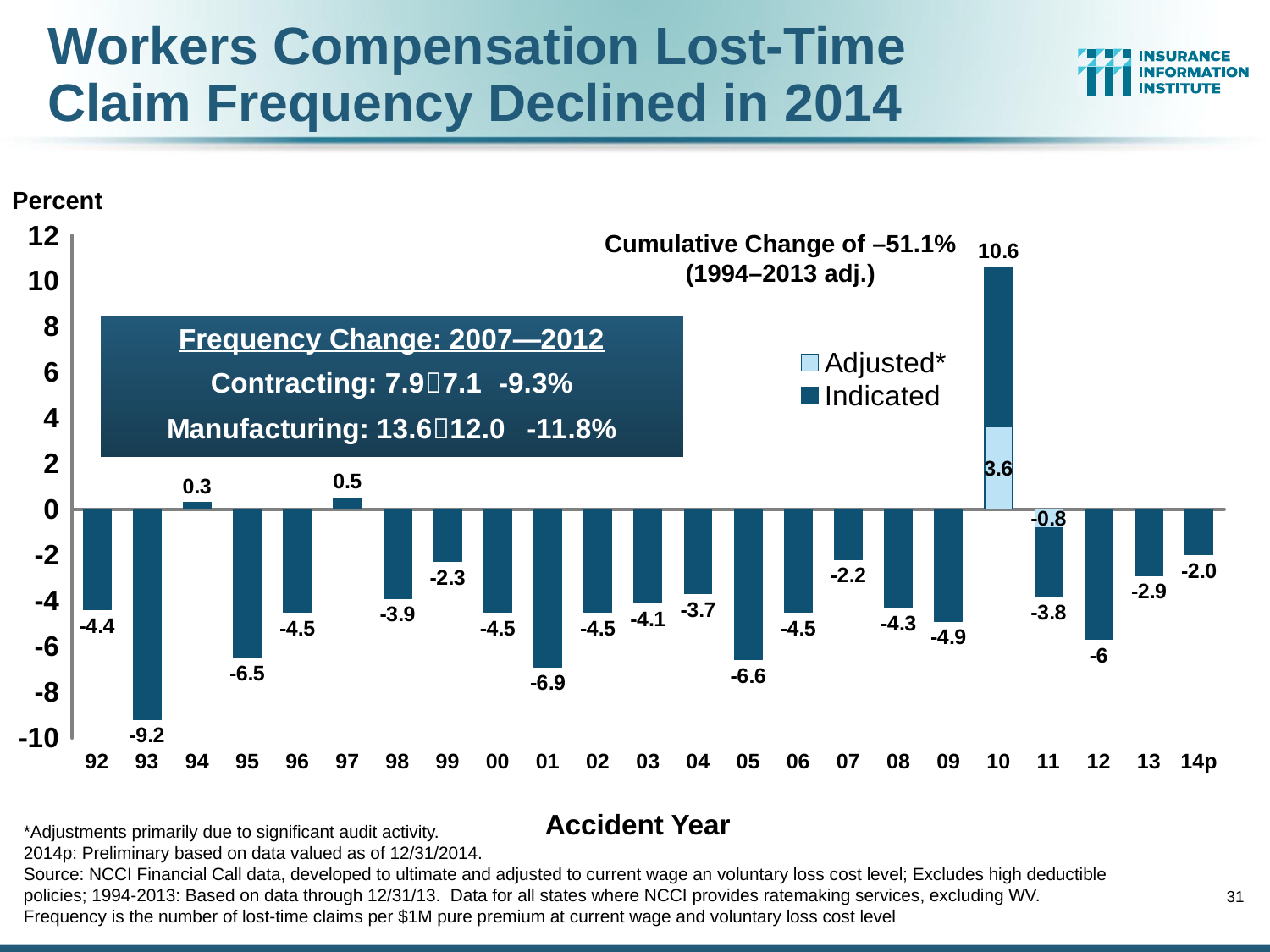
Which accident year has the larger value, 94 or 97? 97 What is the value for accident year 93? -9.2 Which accident year has the lowest value on the chart? 93 What is the value for accident year 14p? -2.0 How many series does the legend list? 2 What are the two entries in the chart legend? Adjusted* and Indicated How many accident years are shown on the x axis? 23 What is the Adjusted value shown for accident year 10? 3.6 What is the value for accident year 12? -6 Which accident year has the highest value on the chart? 10 What is the difference between the values for accident years 13 and 14p? 0.9 What kind of chart is shown on the slide? Bar chart